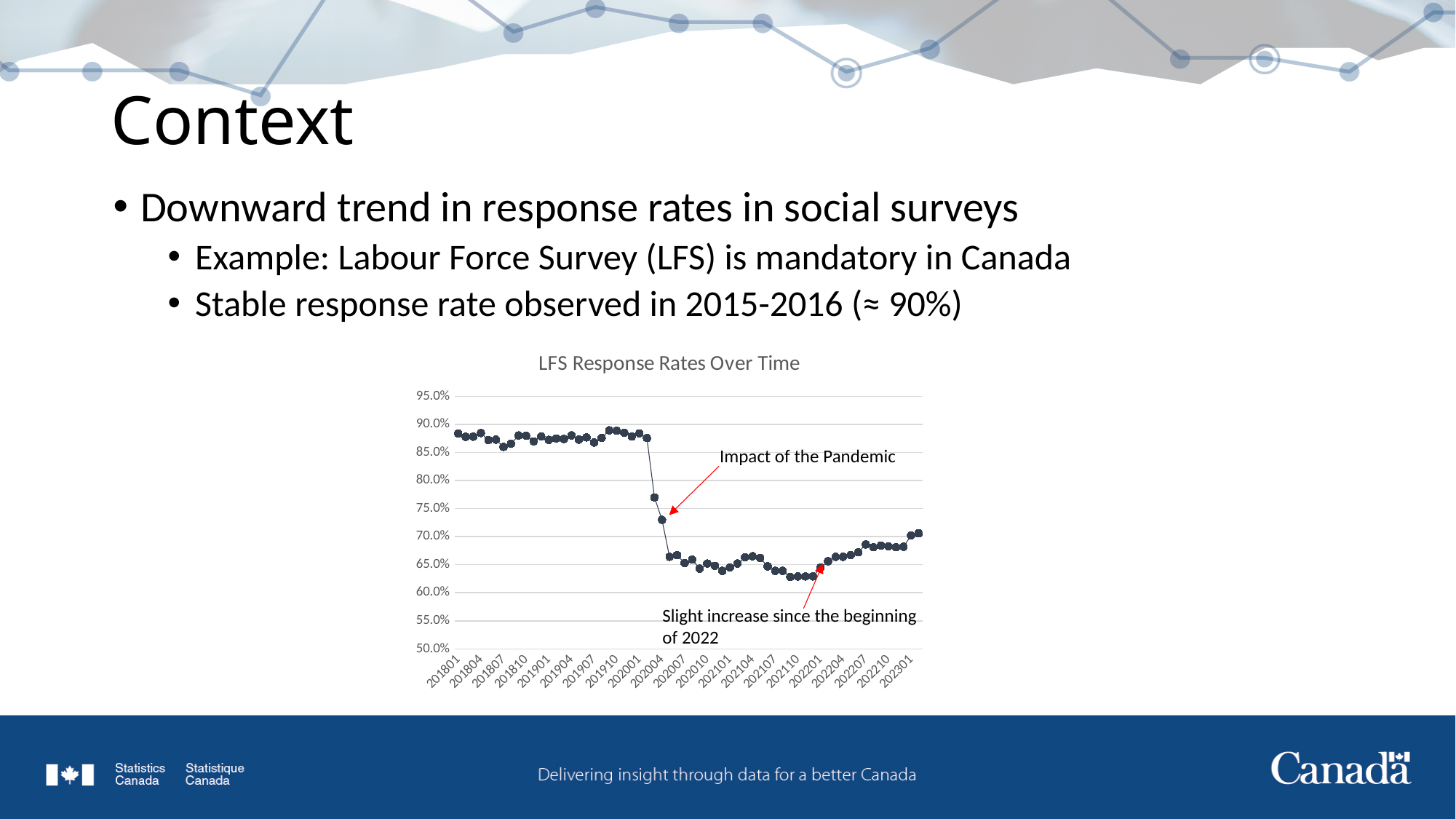
What kind of chart is shown under the title 'LFS Response Rates Over Time'? line chart Is the LFS response rate for 202301 greater or less than 65.0%? greater Which has the higher LFS response rate, 201801 or 202301? 201801 Which has the higher LFS response rate, 202110 or 202207? 202207 How many data series are plotted in the LFS Response Rates Over Time chart? 1 What is the title of the chart on the slide? LFS Response Rates Over Time Is the LFS response rate for 202110 greater or less than 65.0%? less Overall, does the LFS response rate rise or fall from 201801 to 202301? fall Is the LFS response rate for 201801 greater or less than 85.0%? greater What annotation is attached to the sharp drop in the chart around 2020? Impact of the Pandemic